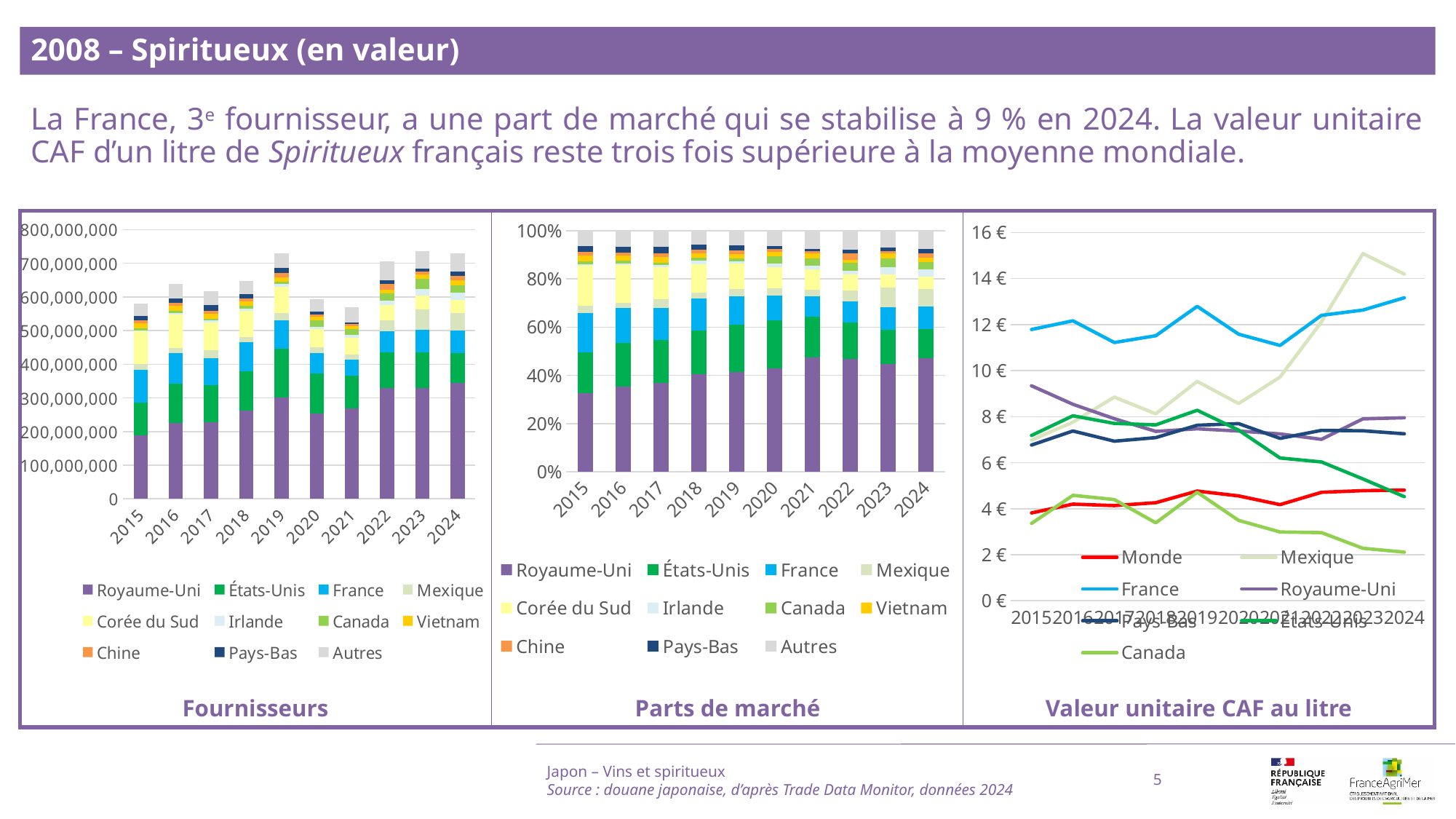
In the 'Valeur unitaire CAF au litre' chart, which is larger in 2024: France or Royaume-Uni? France In the 'Valeur unitaire CAF au litre' chart, does the Mexique line rise or fall between 2015 and 2024? rise In the 'Valeur unitaire CAF au litre' chart, which series has the highest value in 2024? Mexique In the 'Valeur unitaire CAF au litre' chart, which series has the lowest value in 2024? Canada How many series does the legend of the 'Parts de marché' chart list? 11 What kind of chart is the 'Fournisseurs' chart? stacked bar chart In the 'Fournisseurs' chart, is the total of the 2021 bar greater or less than 600,000,000? less How many years are shown on the x axis of the 'Fournisseurs' chart? 10 How many series does the legend of the 'Valeur unitaire CAF au litre' chart list? 7 In the 'Parts de marché' chart, is the Royaume-Uni share in 2024 greater or less than 40%? greater What kind of chart is the 'Valeur unitaire CAF au litre' chart? line chart In the 'Fournisseurs' chart, is the total of the 2019 bar greater or less than 700,000,000? greater